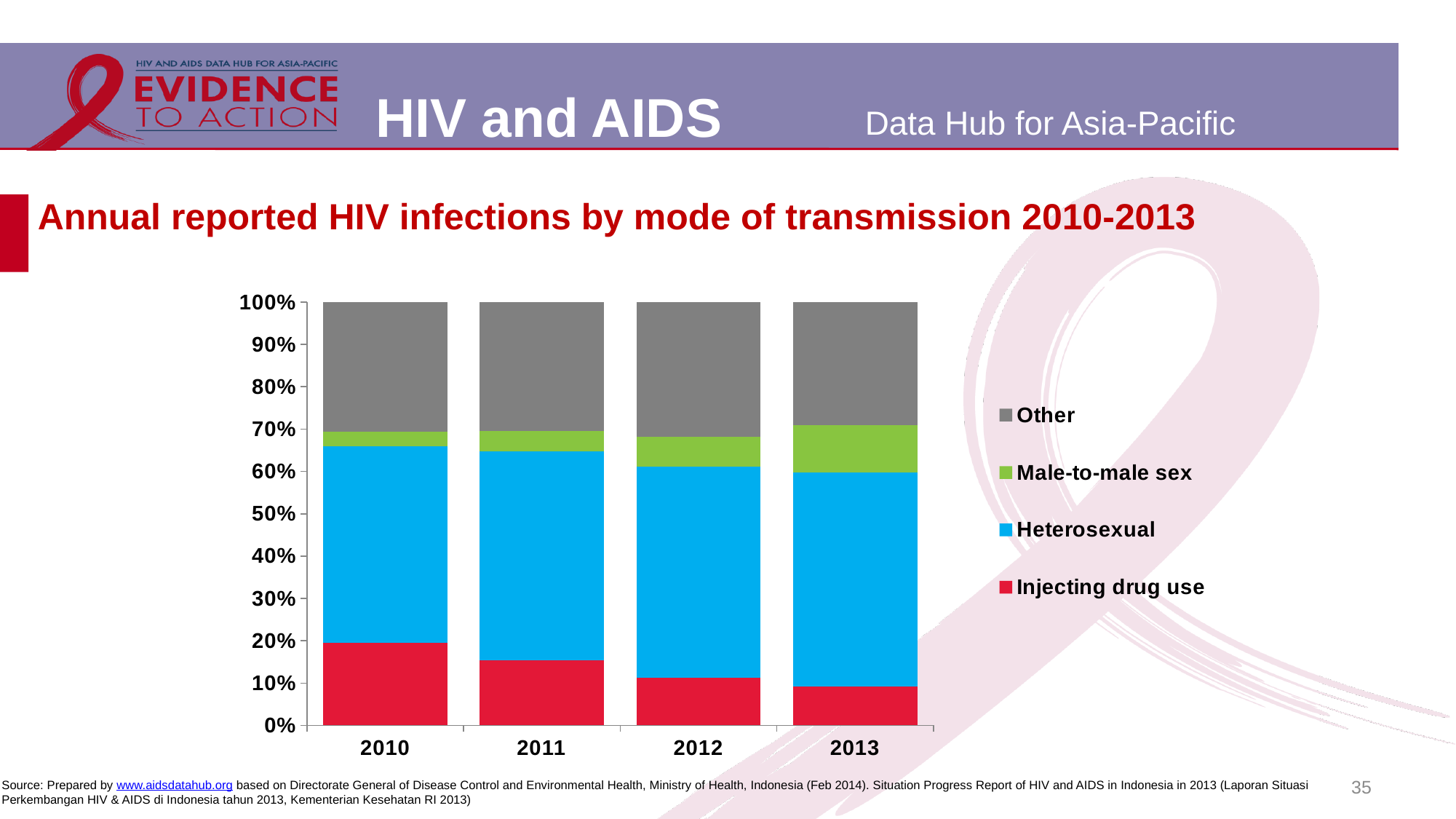
Which series is shown in blue in the chart? Heterosexual Which year has the smallest share for Injecting drug use? 2013 Which is larger: the Injecting drug use share in 2010 or in 2013? 2010 Is the share for Injecting drug use in 2013 greater or less than 20%? less Does the share for Injecting drug use rise or fall from 2010 to 2013? Fall Is the share for Injecting drug use in 2010 greater or less than 10%? greater How many series does the chart legend list? 4 What kind of chart is shown on the slide? Stacked bar chart Does the share for Male-to-male sex rise or fall from 2010 to 2013? Rise Which year has the largest share for Male-to-male sex? 2013 Which year has the largest share for Injecting drug use? 2010 How many years are shown on the x axis of the chart? 4